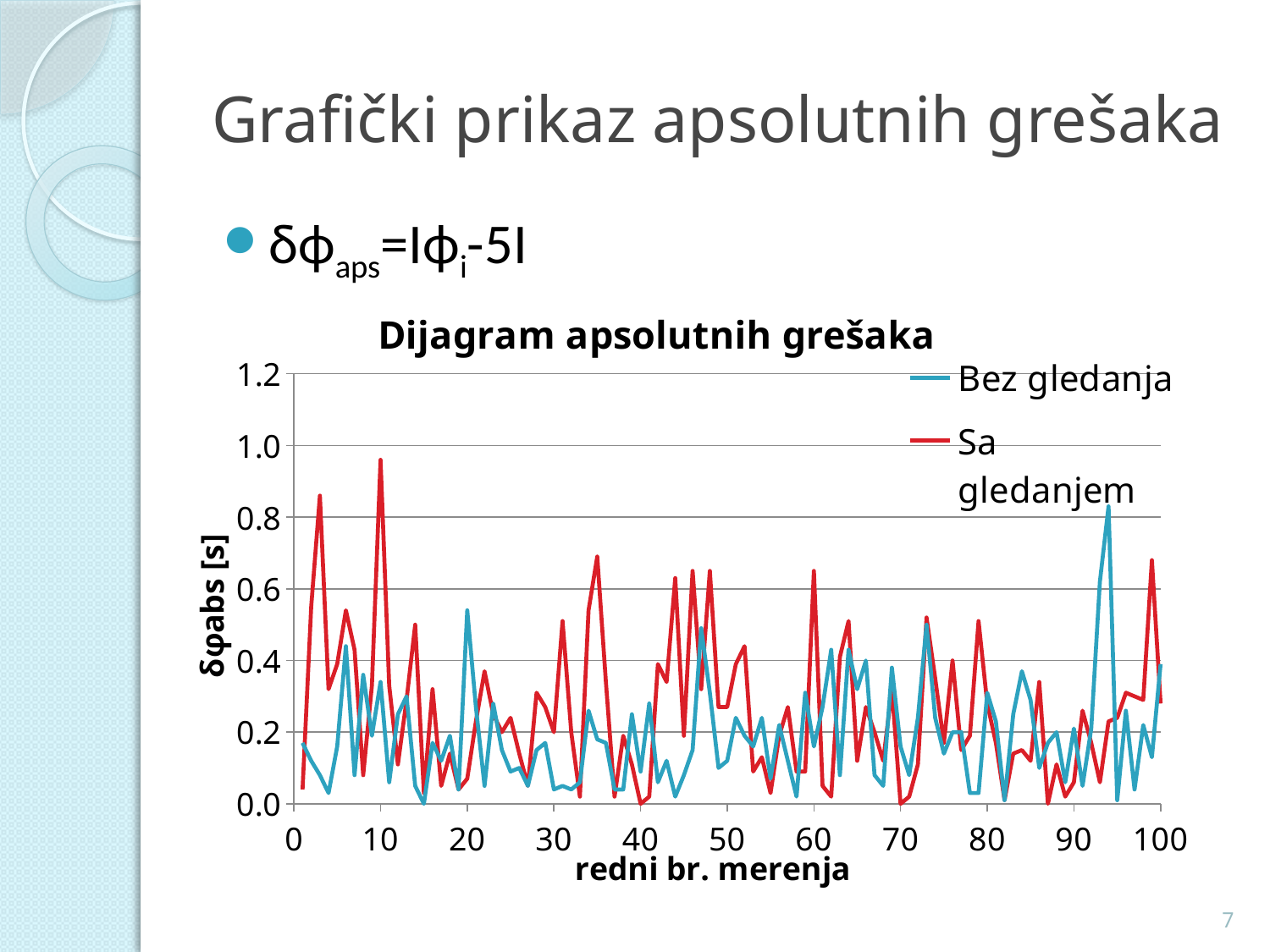
Is the value of 'Bez gledanja' at measurement 20 greater or less than 0.4? greater Is the value of 'Bez gledanja' at measurement 94 greater or less than 0.6? greater How many series does the legend list? 2 What is the label of the x axis? redni br. merenja What kind of chart is shown on the slide? line chart At which measurement number does the 'Sa gledanjem' series reach its highest value? 10 Is the value of 'Sa gledanjem' at measurement 10 greater or less than 0.8? greater Which series reaches the highest value anywhere on the chart, 'Bez gledanja' or 'Sa gledanjem'? Sa gledanjem What is the title of the chart? Dijagram apsolutnih grešaka Which series is drawn in red? Sa gledanjem